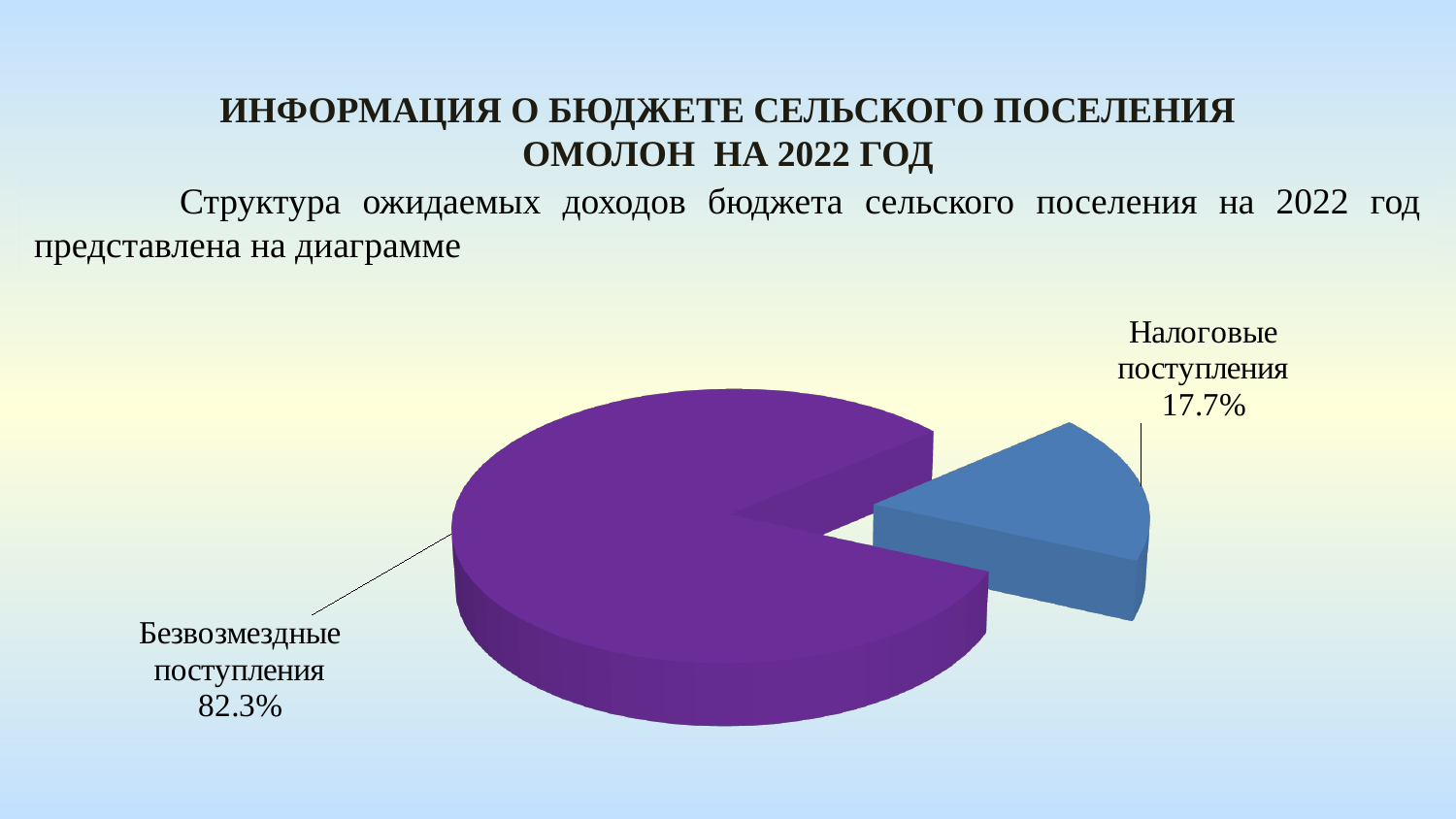
Which slice of the pie is the smallest? Налоговые поступления What is the difference in percentage points between Безвозмездные поступления and Налоговые поступления? 64.6 Which slice of the pie is the largest? Безвозмездные поступления Which is larger, Налоговые поступления or Безвозмездные поступления? Безвозмездные поступления What colour is the slice for Безвозмездные поступления? Purple What colour is the slice for Налоговые поступления? Blue What is the total of the two slices shown in the pie chart? 100% What share of the pie does Безвозмездные поступления represent? 82.3% How many slices does the pie chart have? 2 What kind of chart is shown on the slide? Pie chart What share of the pie does Налоговые поступления represent? 17.7%